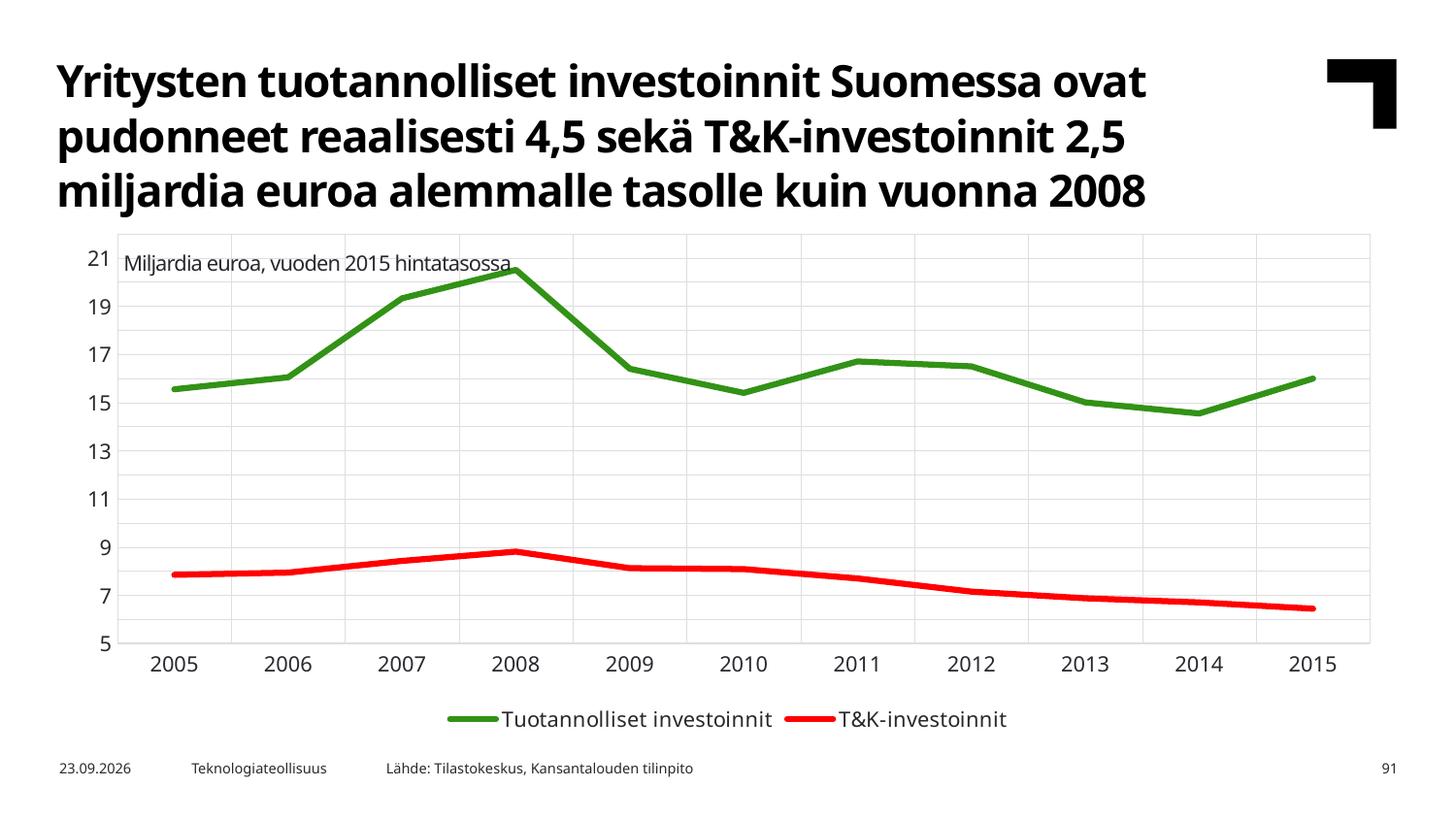
In which year is the value for Tuotannolliset investoinnit lowest? 2014 What kind of chart is shown on the slide? line chart Which series has the larger value in 2010, Tuotannolliset investoinnit or T&K-investoinnit? Tuotannolliset investoinnit In which year is the value for T&K-investoinnit lowest? 2015 How many series does the legend list? 2 Is the value for Tuotannolliset investoinnit in 2008 greater or less than 19? greater How many years are shown on the x axis? 11 In which year is the value for T&K-investoinnit highest? 2008 What colour is the line for T&K-investoinnit? red Do the values for T&K-investoinnit rise or fall from 2008 to 2015? fall In which year is the value for Tuotannolliset investoinnit highest? 2008 Is the value for T&K-investoinnit in 2015 greater or less than 7? less